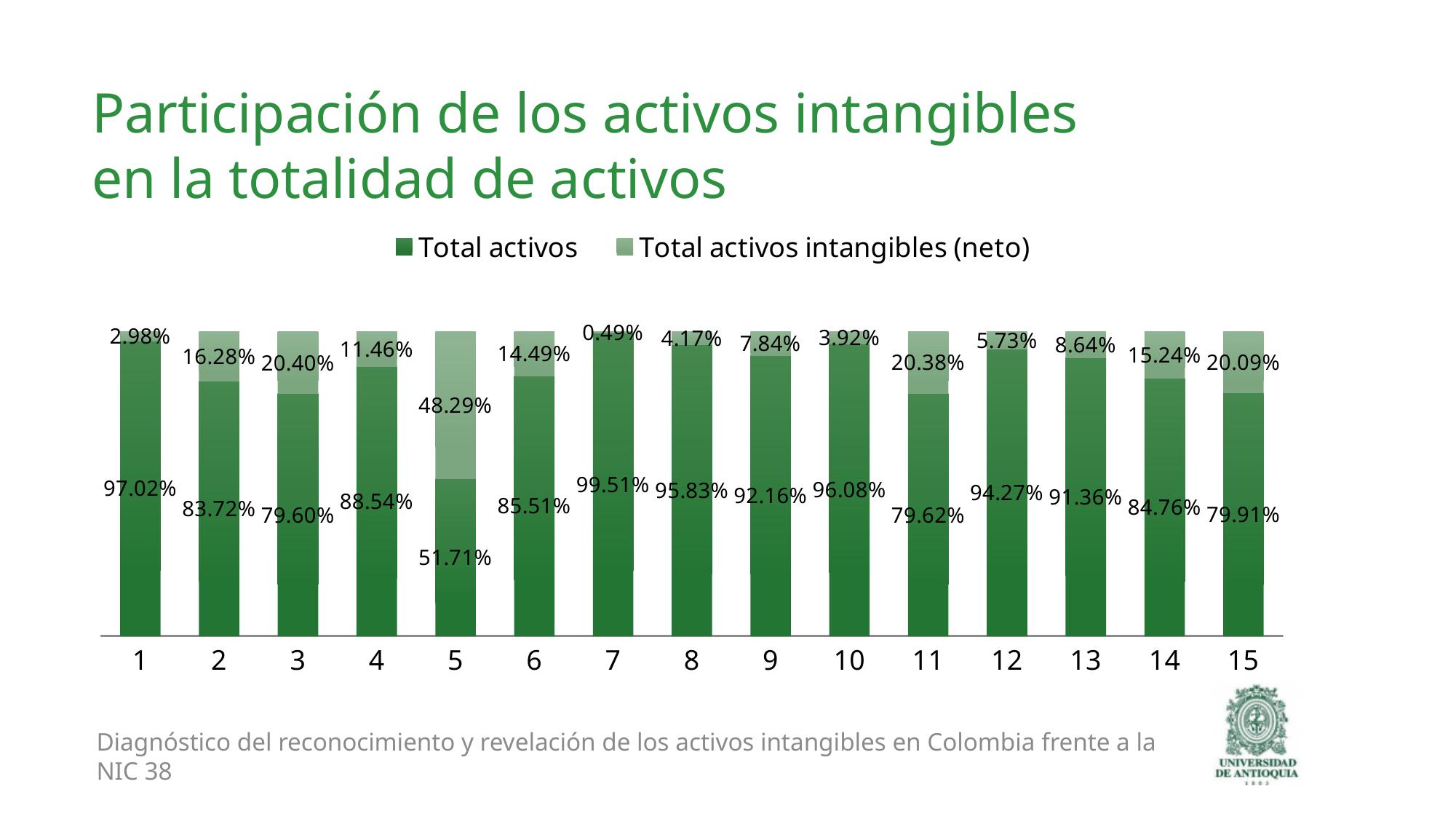
Which category has the lowest value for Total activos? 5 What is the difference between the Total activos intangibles (neto) values for category 3 and category 2? 4.12% Which category has the lowest value for Total activos intangibles (neto)? 7 Which has a larger Total activos intangibles (neto) value, category 11 or category 12? 11 What is the value of Total activos intangibles (neto) for category 5? 48.29% How many categories are shown on the x axis? 15 What kind of chart is shown on the slide? Stacked bar chart What is the value of Total activos intangibles (neto) for category 7? 0.49% How many series does the legend list? 2 What is the difference between Total activos and Total activos intangibles (neto) for category 5? 3.42% Which category has the highest value for Total activos intangibles (neto)? 5 What is the value of Total activos for category 11? 79.62%